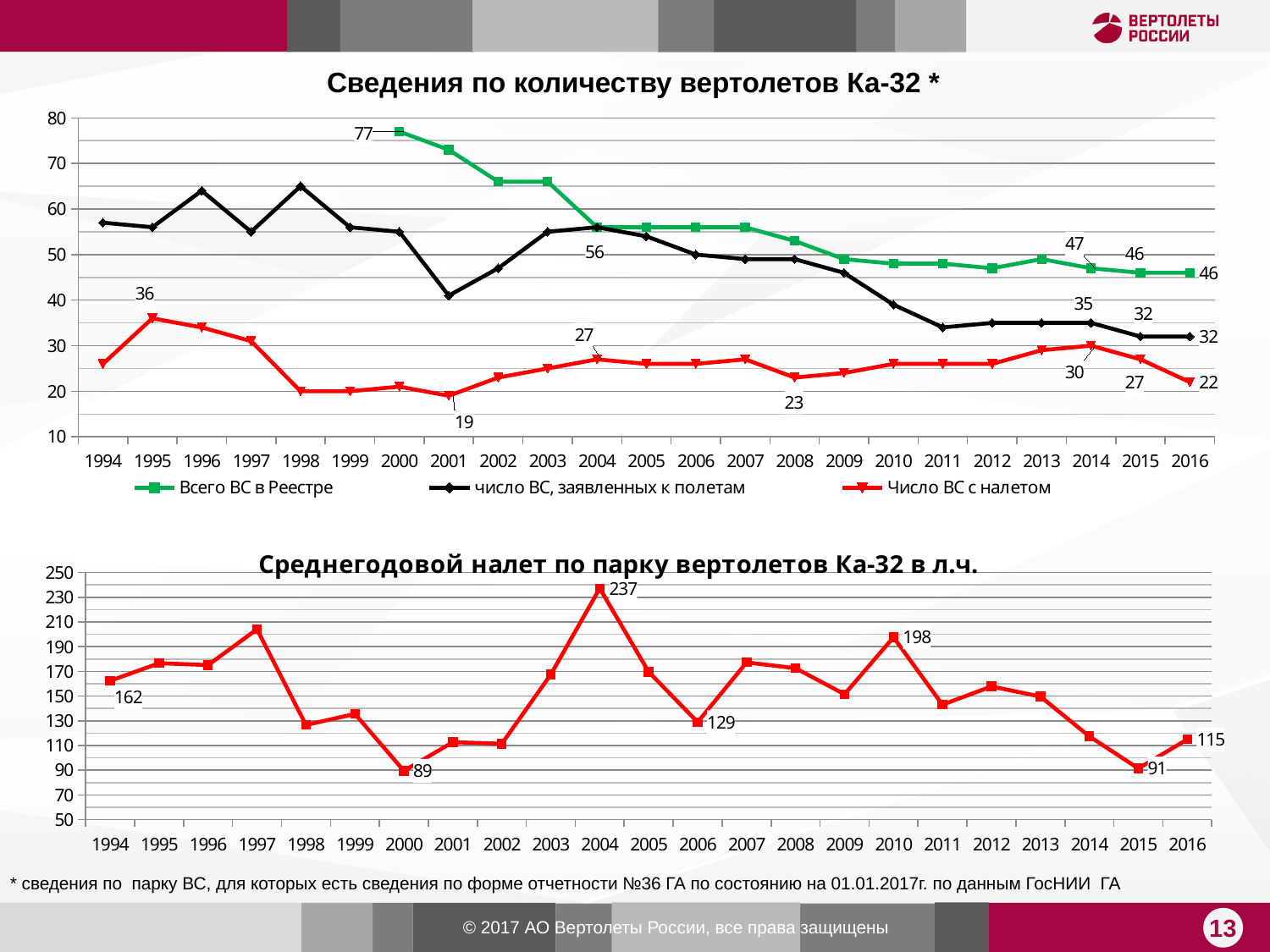
In the top chart, does 'Всего ВС в Реестре' rise or fall from 2000 to 2016? Fall In the bottom chart 'Среднегодовой налет по парку вертолетов Ка-32 в л.ч.', what is the value for 2010? 198 In the top chart, what is the value of 'число ВС, заявленных к полетам' in 2016? 32 In the top chart, which is larger in 2001: 'Всего ВС в Реестре' or 'число ВС, заявленных к полетам'? Всего ВС в Реестре In the bottom chart 'Среднегодовой налет по парку вертолетов Ка-32 в л.ч.', which year has the highest value? 2004 In the top chart, what is the value of 'Всего ВС в Реестре' in 2000? 77 In the top chart, what is the value of 'Число ВС с налетом' in 2016? 22 In the bottom chart 'Среднегодовой налет по парку вертолетов Ка-32 в л.ч.', is the value for 1997 greater or less than 170? greater What kind of chart is the top chart, 'Сведения по количеству вертолетов Ка-32'? Line chart How many series does the legend of the top chart list? 3 In the bottom chart 'Среднегодовой налет по парку вертолетов Ка-32 в л.ч.', what is the difference between the 2004 value and the 2000 value? 148 In the top chart, what is the difference between 'Всего ВС в Реестре' and 'число ВС, заявленных к полетам' in 2016? 14